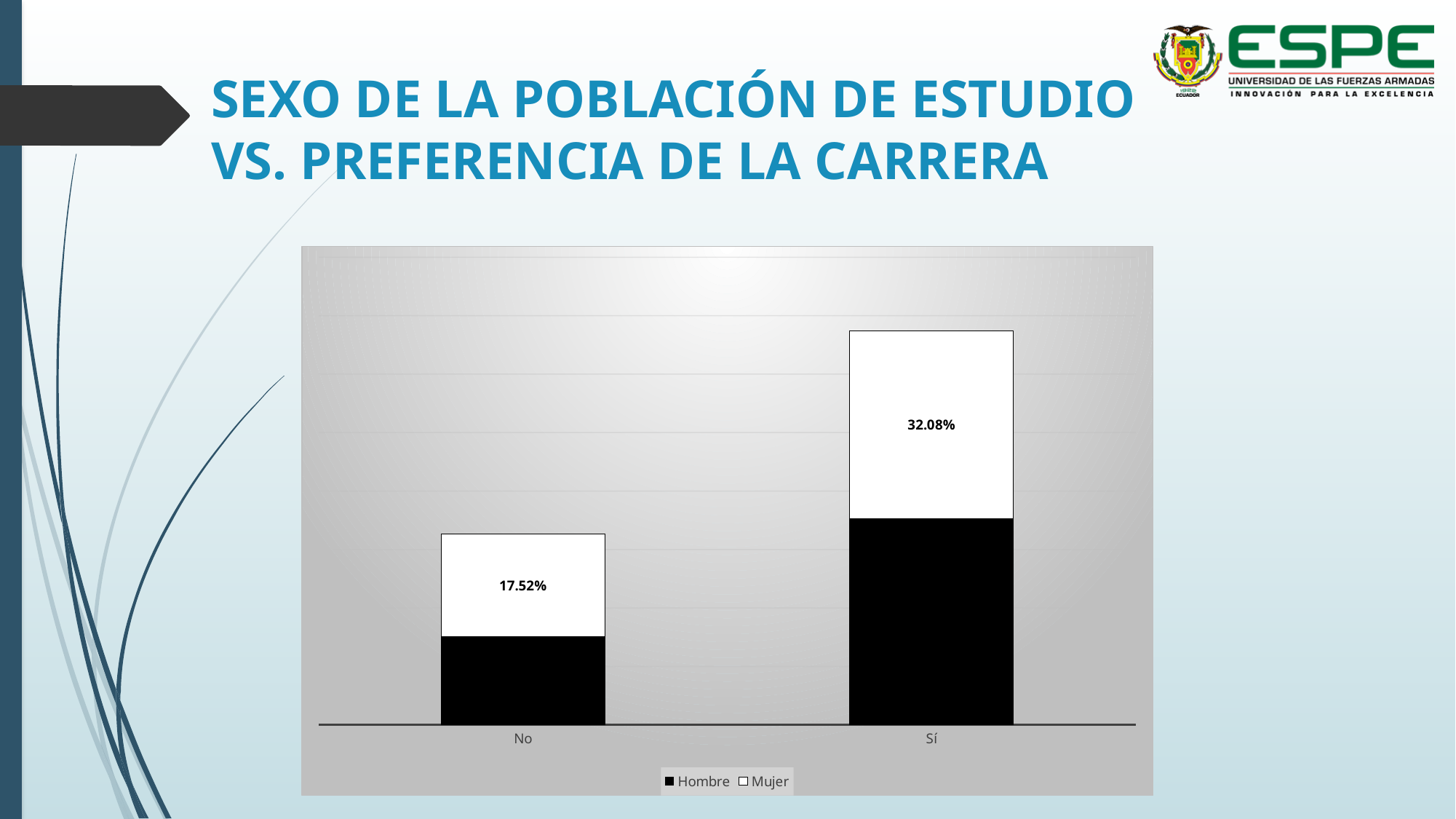
What is the difference between the Mujer values for Sí and No? 14.56% How many categories are shown on the x axis? 2 What colour represents the Hombre series? Black What kind of chart is shown on the slide? Stacked bar chart What is the value for Mujer in the Sí category? 32.08% What are the two series named in the legend? Hombre and Mujer How many series does the legend list? 2 Which category has the taller stacked bar overall? Sí Which category has the larger Hombre segment, No or Sí? Sí What is the value for Mujer in the No category? 17.52% Which category has the higher Mujer value, No or Sí? Sí Which category has the lower Mujer value? No